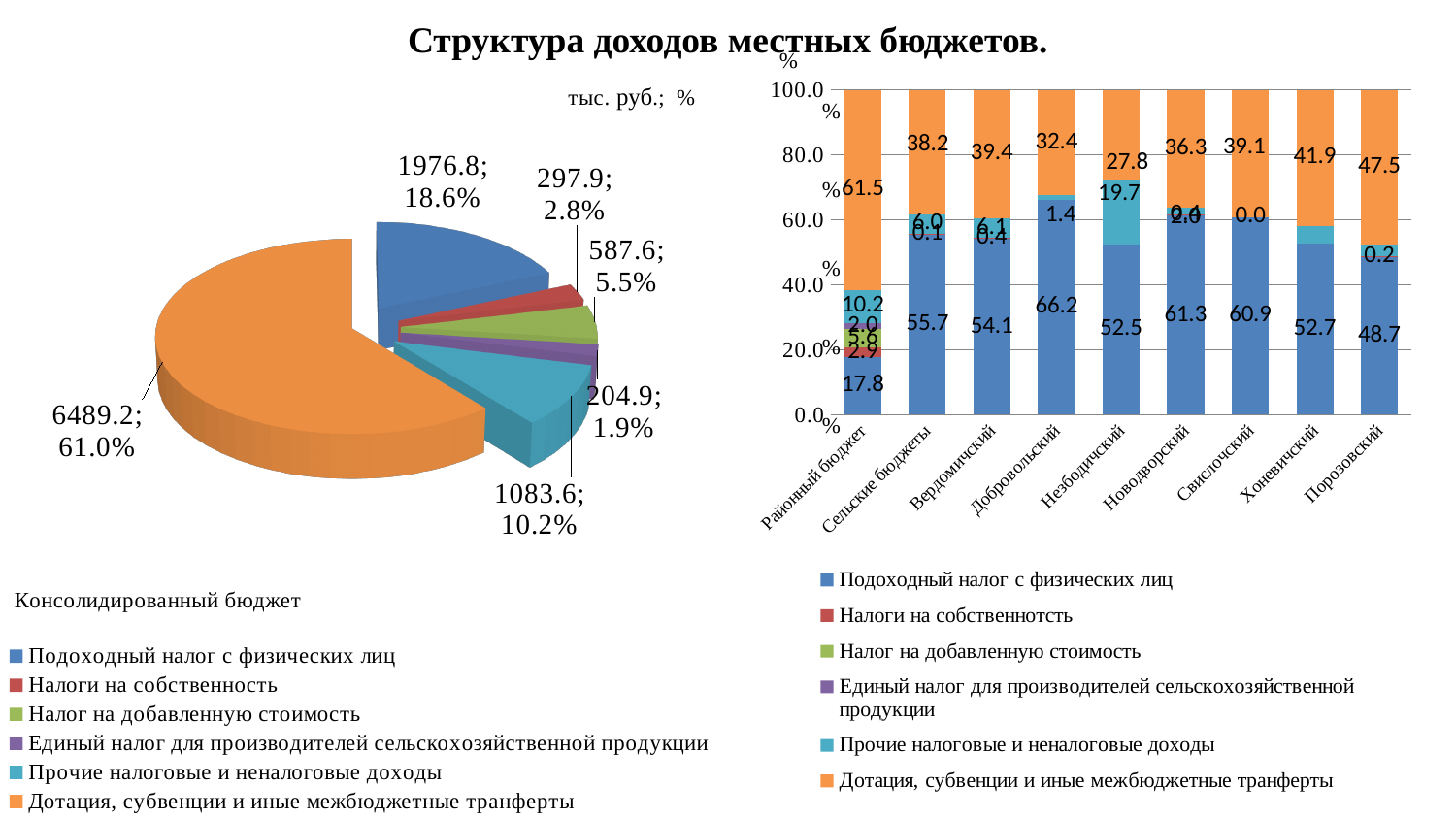
In the stacked bar chart on the right, what is the value of 'Дотация, субвенции и иные межбюджетные транферты' for Порозовский? 47.5 In the pie chart on the left, what value is shown for the slice 'Дотация, субвенции и иные межбюджетные транферты'? 6489.2; 61.0% How many series does the legend of the stacked bar chart on the right list? 6 In the stacked bar chart on the right, what is the difference between the 'Подоходный налог с физических лиц' values for Добровольский and Порозовский? 17.5 In the stacked bar chart on the right, which category has the highest value for 'Подоходный налог с физических лиц'? Добровольский In the stacked bar chart on the right, which is larger: the 'Дотация, субвенции и иные межбюджетные транферты' value for Хоневичский or for Порозовский? Порозовский In the stacked bar chart on the right, what is the value of 'Подоходный налог с физических лиц' for Добровольский? 66.2 In the stacked bar chart on the right, which category has the lowest value for 'Подоходный налог с физических лиц'? Районный бюджет In the pie chart on the left, what value is shown for 'Прочие налоговые и неналоговые доходы'? 1083.6; 10.2% In the pie chart on the left, what share of the pie does 'Подоходный налог с физических лиц' take? 18.6% How many categories are shown on the x axis of the stacked bar chart on the right? 9 In the pie chart on the left, which category has the smallest slice? Единый налог для производителей сельскохозяйственной продукции